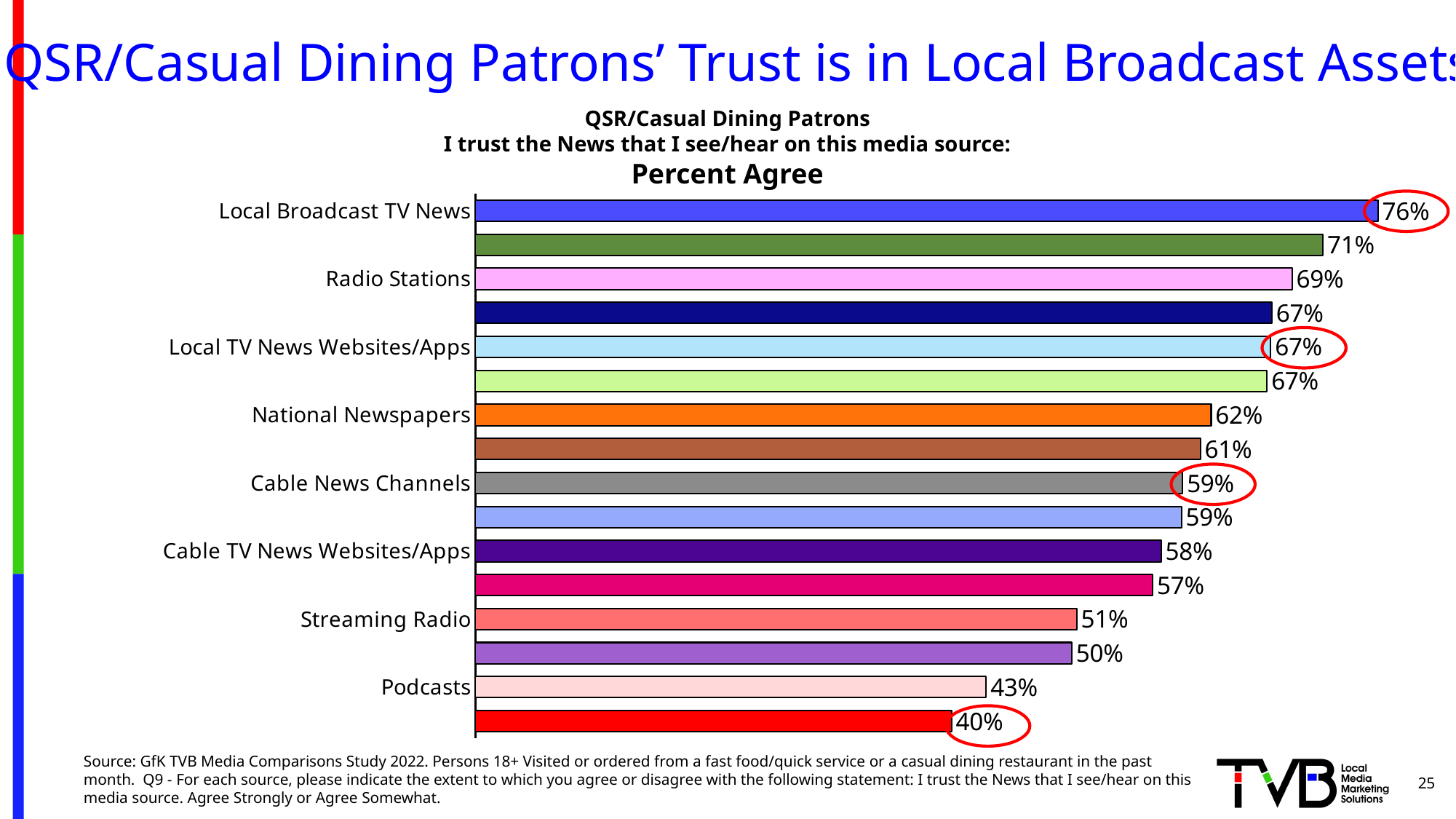
Do the Percent Agree values increase or decrease going from the top bar to the bottom bar? Decrease What is the value shown on the lowest bar in the chart? 40% What is the Percent Agree value for Podcasts? 43% What is the Percent Agree value for Local TV News Websites/Apps? 67% What is the Percent Agree value for National Newspapers? 62% How many bars are plotted in the chart? 16 What type of chart is shown on the slide? Bar chart What percentage of QSR/Casual Dining Patrons agree they trust the news on Local Broadcast TV News? 76% What is the Percent Agree value for Radio Stations? 69% Which has a higher Percent Agree: Streaming Radio or Cable TV News Websites/Apps? Cable TV News Websites/Apps Which labeled media source has the highest Percent Agree? Local Broadcast TV News What is the difference in Percent Agree between Local Broadcast TV News and Cable News Channels? 17 percentage points